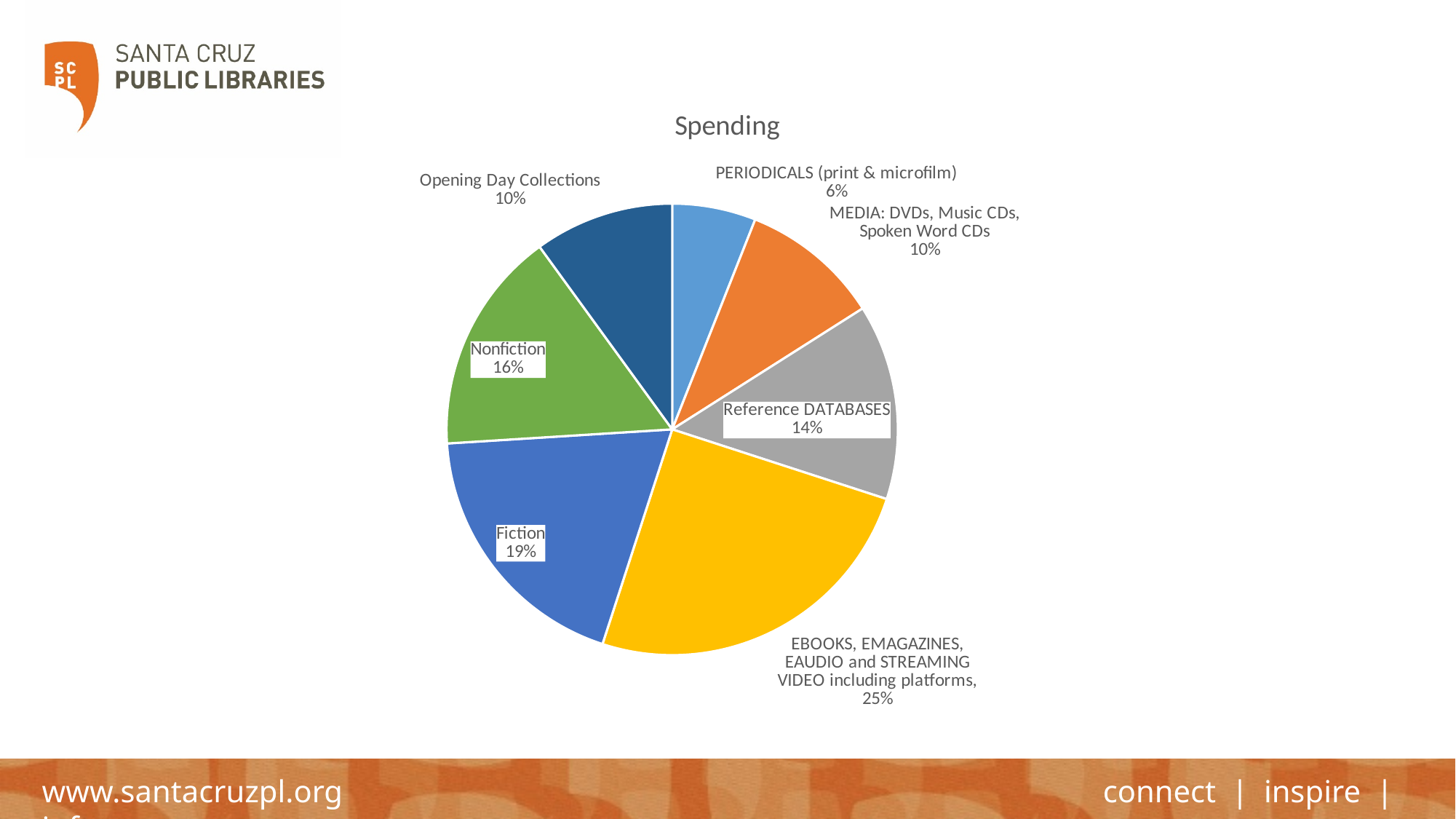
What is the title of the chart? Spending What share of spending goes to Fiction? 19% What share of spending goes to Nonfiction? 16% What share of spending goes to PERIODICALS (print & microfilm)? 6% Which category has the largest share of spending? EBOOKS, EMAGAZINES, EAUDIO and STREAMING VIDEO including platforms Which category has the smallest share of spending? PERIODICALS (print & microfilm) What share of spending goes to Reference DATABASES? 14% What kind of chart is shown on the slide? pie chart Which has a larger share, Reference DATABASES or Opening Day Collections? Reference DATABASES What colour is the Fiction slice? blue How many categories are shown in the pie chart? 7 What is the difference in percentage points between Fiction and Nonfiction? 3